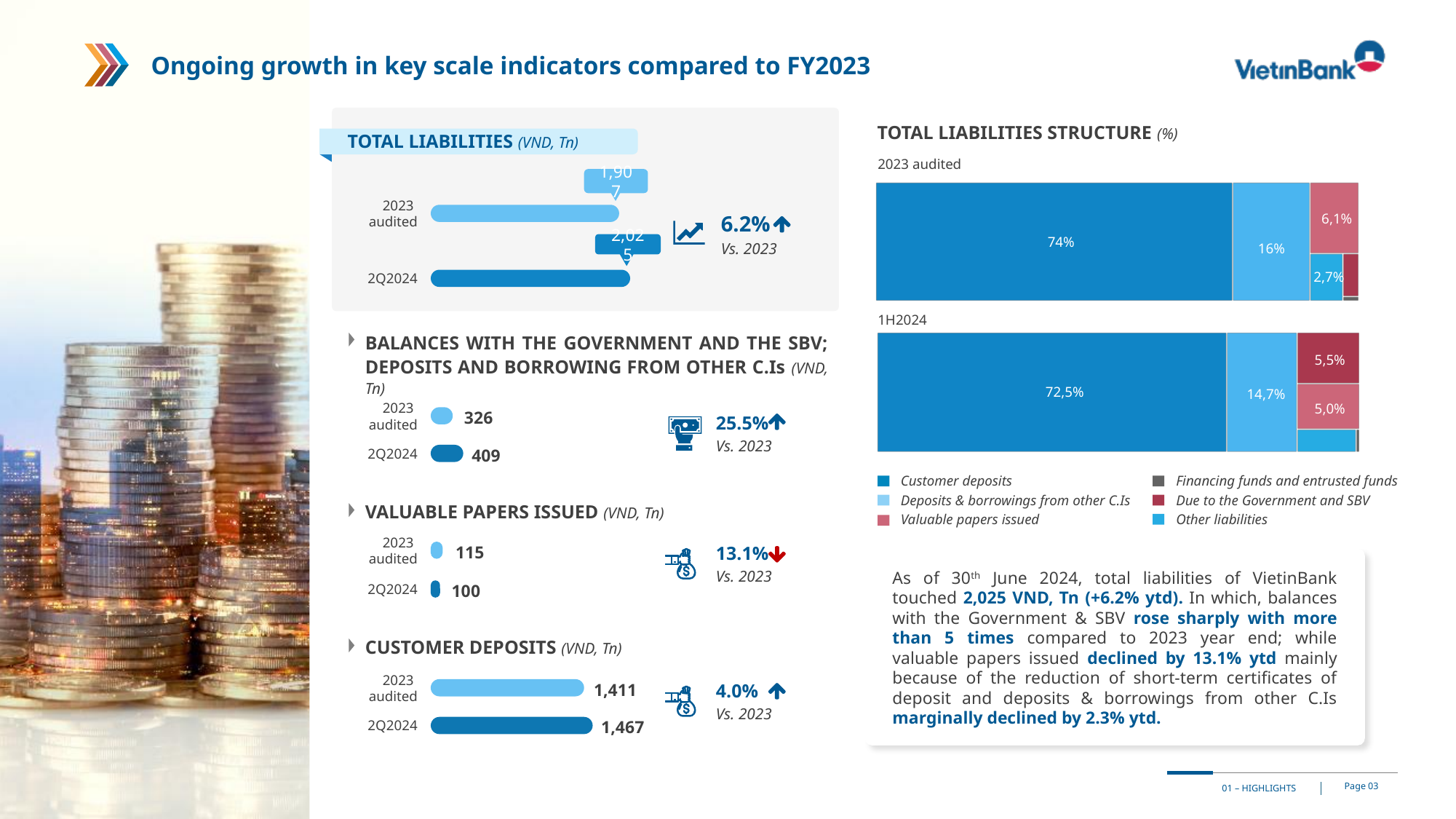
In the Total Liabilities Structure chart, what share do customer deposits have in 1H2024? 72,5% In the Customer Deposits chart, what is the value for 2Q2024? 1,467 In the Valuable Papers Issued chart, which period has the lower value, 2023 audited or 2Q2024? 2Q2024 How many categories does the legend of the Total Liabilities Structure chart list? 6 In the Total Liabilities Structure chart, what share do deposits & borrowings from other C.Is have in 2023 audited? 16% In the Total Liabilities chart, what is the value for 2023 audited? 1,907 In the Total Liabilities chart, what is the value for 2Q2024? 2,025 In the Valuable Papers Issued chart, what is the value for 2023 audited? 115 In the Balances with the Government and the SBV chart, what is the difference between 2Q2024 and 2023 audited? 83 In the Balances with the Government and the SBV chart, what is the value for 2Q2024? 409 In the Customer Deposits chart, what is the difference between 2Q2024 and 2023 audited? 56 In the Total Liabilities chart, what percentage change vs. 2023 is shown? 6.2%